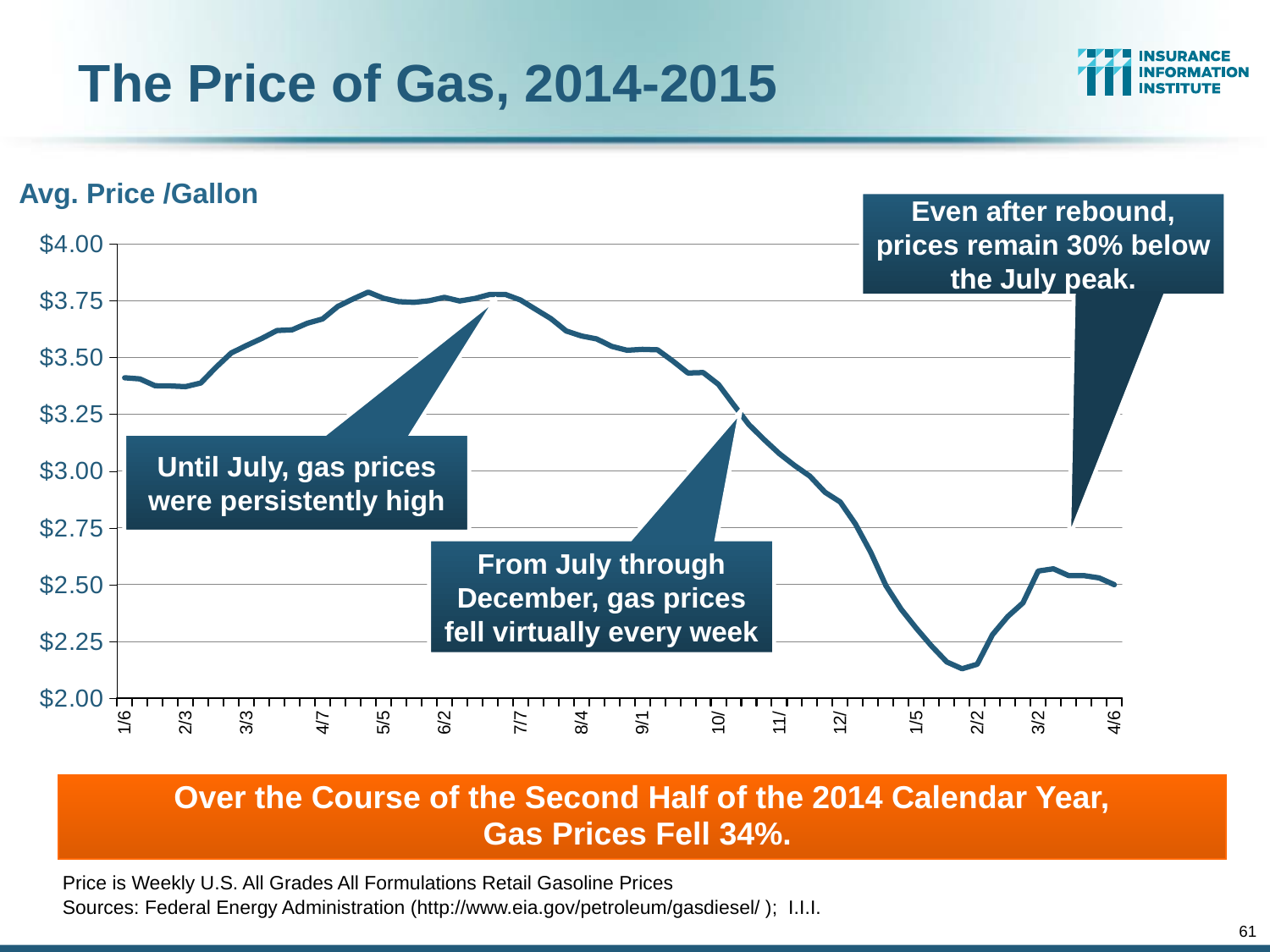
Do gas prices rise or fall between 7/7 and 1/5? fall Is the value at 2/2 greater or less than $2.25? less Is the value at 7/7 greater or less than $3.50? greater Do gas prices rise or fall between 1/6 and 7/7? rise Which is larger, the value at 1/6 or the value at 4/6? 1/6 Which is larger, the value at 7/7 or the value at 2/2? 7/7 Is the value at 11/ greater or less than $3.25? less What label is given to the vertical axis of the chart? Avg. Price /Gallon What is the title of the slide's chart? The Price of Gas, 2014-2015 What kind of chart is shown on the slide? line chart